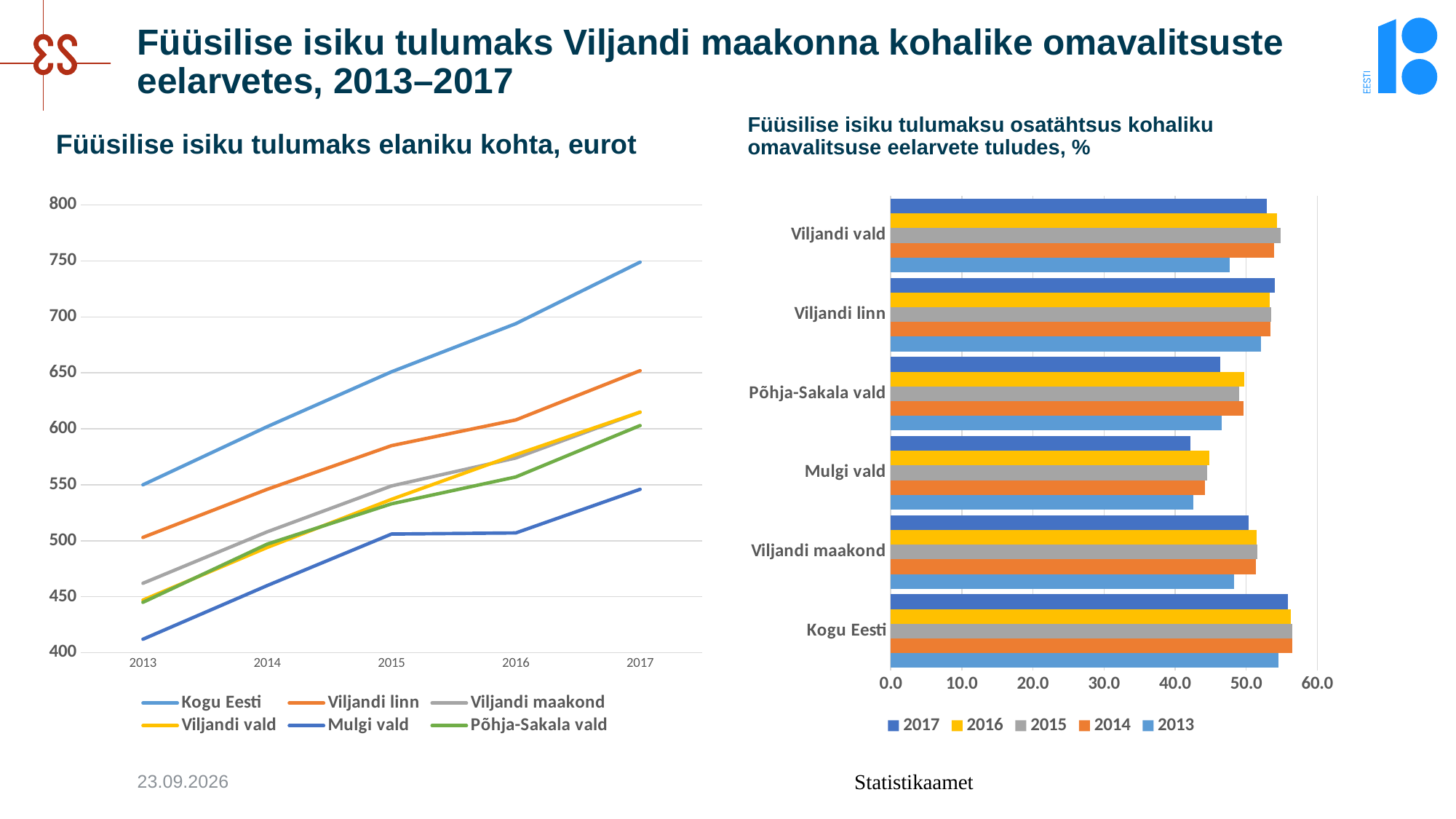
In the left chart, does the value for Kogu Eesti rise or fall from 2013 to 2017? rise In the right chart, is the 2017 value for Mulgi vald greater or less than 50.0? less In the right chart, how many series does the legend list? 5 What kind of chart is the left chart, 'Füüsilise isiku tulumaks elaniku kohta, eurot'? line chart In the left chart, how many years are shown on the x axis? 5 In the right chart, how many categories are shown on the vertical axis? 6 What kind of chart is the right chart, 'Füüsilise isiku tulumaksu osatähtsus kohaliku omavalitsuse eelarvete tuludes, %'? bar chart In the left chart, which series has the highest value in 2017? Kogu Eesti In the right chart, which category has the lowest 2017 value? Mulgi vald In the left chart, which series has the lowest value in 2013? Mulgi vald In the left chart, how many series does the legend list? 6 In the left chart, is the value for Kogu Eesti in 2017 greater or less than 700? greater